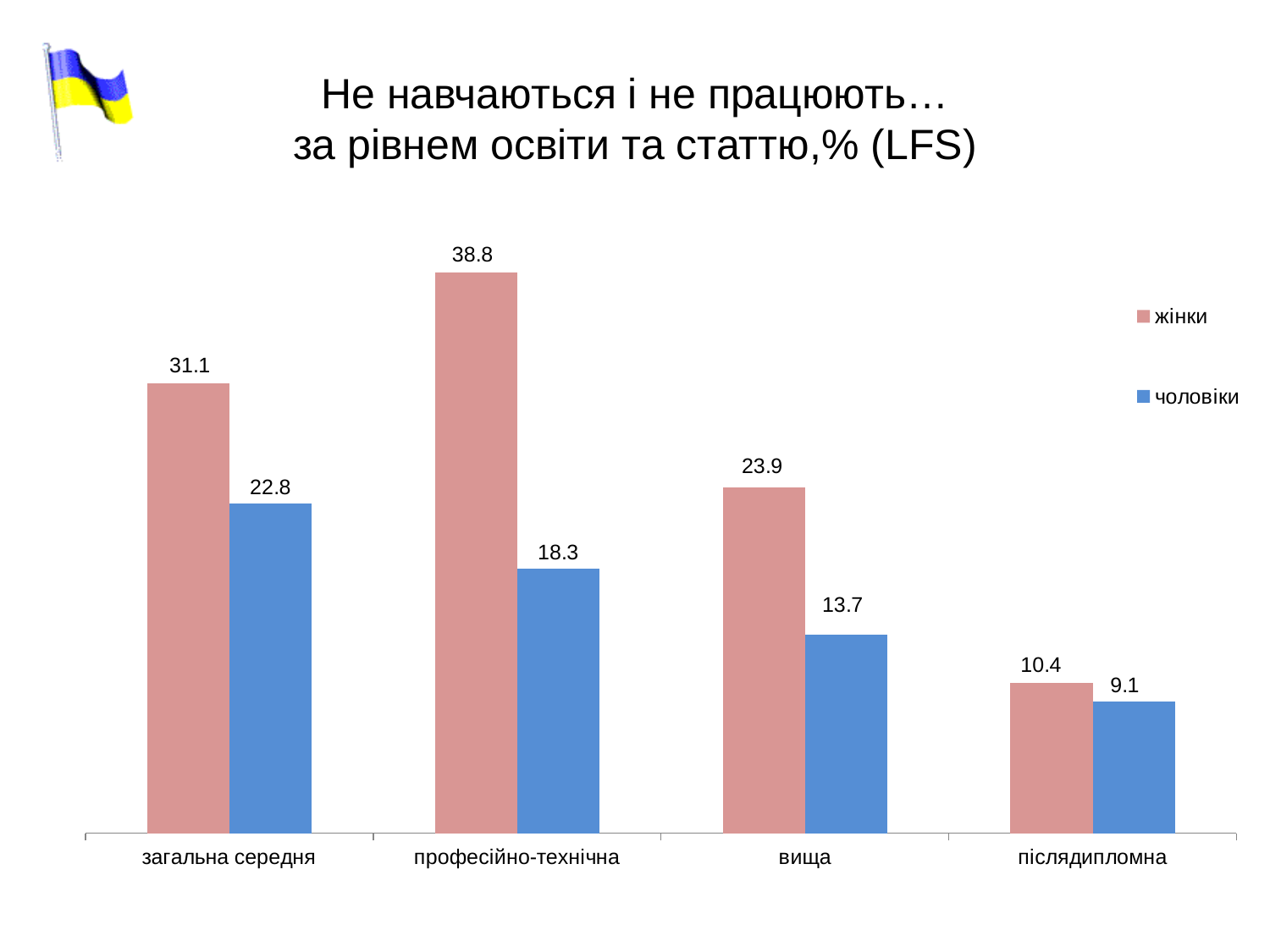
What is the value for чоловіки in the вища category? 13.7 Which colour represents the чоловіки series? blue What kind of chart is shown on the slide? bar chart Which is larger: чоловіки for загальна середня or чоловіки for професійно-технічна? чоловіки for загальна середня What is the value for жінки in the післядипломна category? 10.4 What is the difference between the жінки values for загальна середня and вища? 7.2 How many education-level categories are shown on the x axis? 4 What is the difference between жінки and чоловіки in the професійно-технічна category? 20.5 How many series does the legend list? 2 Which category has the lowest value for чоловіки? післядипломна What is the value for жінки in the професійно-технічна category? 38.8 Which category has the highest value for жінки? професійно-технічна